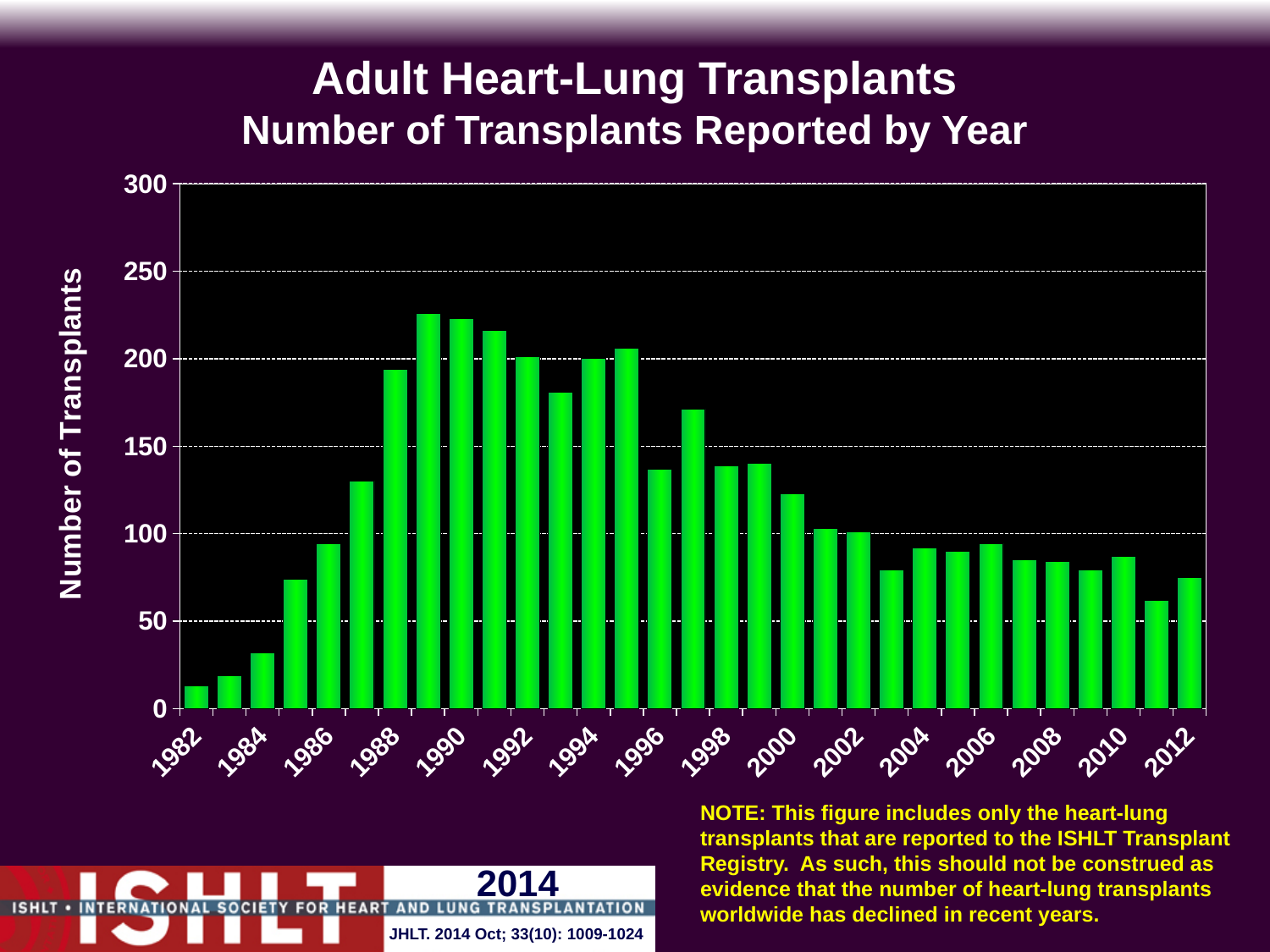
Which year has the lowest number of transplants? 1982 Is the value for 1982 greater or less than 50? less Which year has more transplants, 1984 or 2010? 2010 What kind of chart is shown on the slide? bar chart What is the label of the vertical axis? Number of Transplants Is the value for 2012 greater or less than 50? greater Which year has more transplants, 1988 or 2008? 1988 Is the value for 1996 greater or less than 150? less Do the values rise or fall from 1982 to 1989? rise How many years (bars) are plotted in the chart? 31